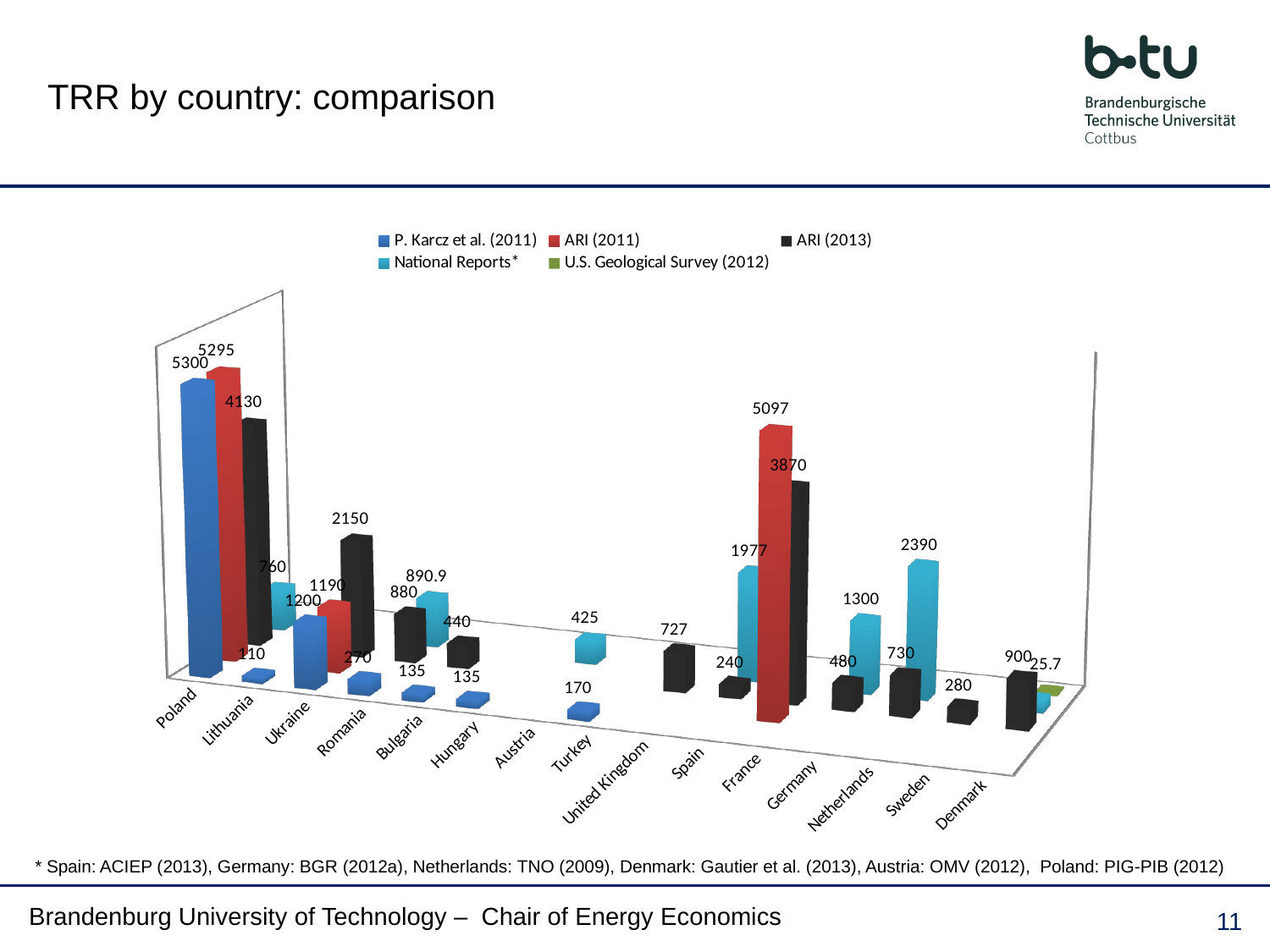
What is the difference between the ARI (2011) and ARI (2013) values for France? 1227 What kind of chart is shown on the slide? bar chart How many countries are shown on the x axis? 15 What is the P. Karcz et al. (2011) value for Poland? 5300 What colour represents the ARI (2011) series in the legend? red What is the National Reports value for the Netherlands? 2390 What is the ARI (2011) value for France? 5097 What is the ARI (2013) value for Ukraine? 2150 Which country has the highest ARI (2011) value? Poland Which is larger, the ARI (2013) value for Poland or for France? Poland What is the P. Karcz et al. (2011) value for Lithuania? 110 How many series does the legend list? 5